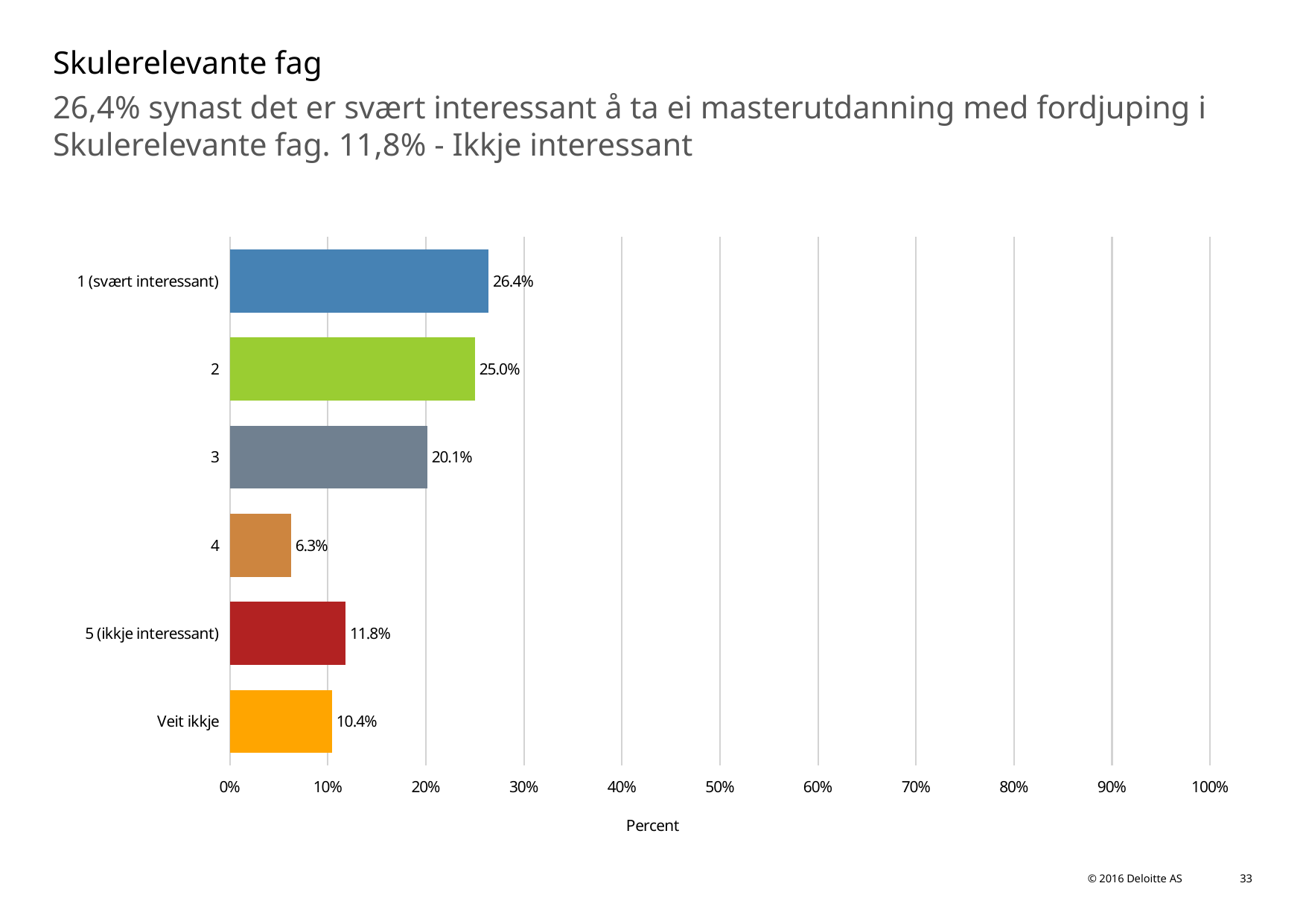
What is the difference between the values for "1 (svært interessant)" and "5 (ikkje interessant)"? 14.6% Which category has the lowest value? 4 What is the value for "Veit ikkje"? 10.4% Which category has the highest value? 1 (svært interessant) What is the label of the horizontal axis? Percent What is the difference between the values for category 2 and category 3? 4.9% What is the value for "1 (svært interessant)"? 26.4% How many categories are shown in the chart? 6 Is the value for category 3 greater or less than 30%? less What is the value for category 3? 20.1% Which is larger, the value for "5 (ikkje interessant)" or the value for "Veit ikkje"? 5 (ikkje interessant) What kind of chart is shown on the slide? bar chart